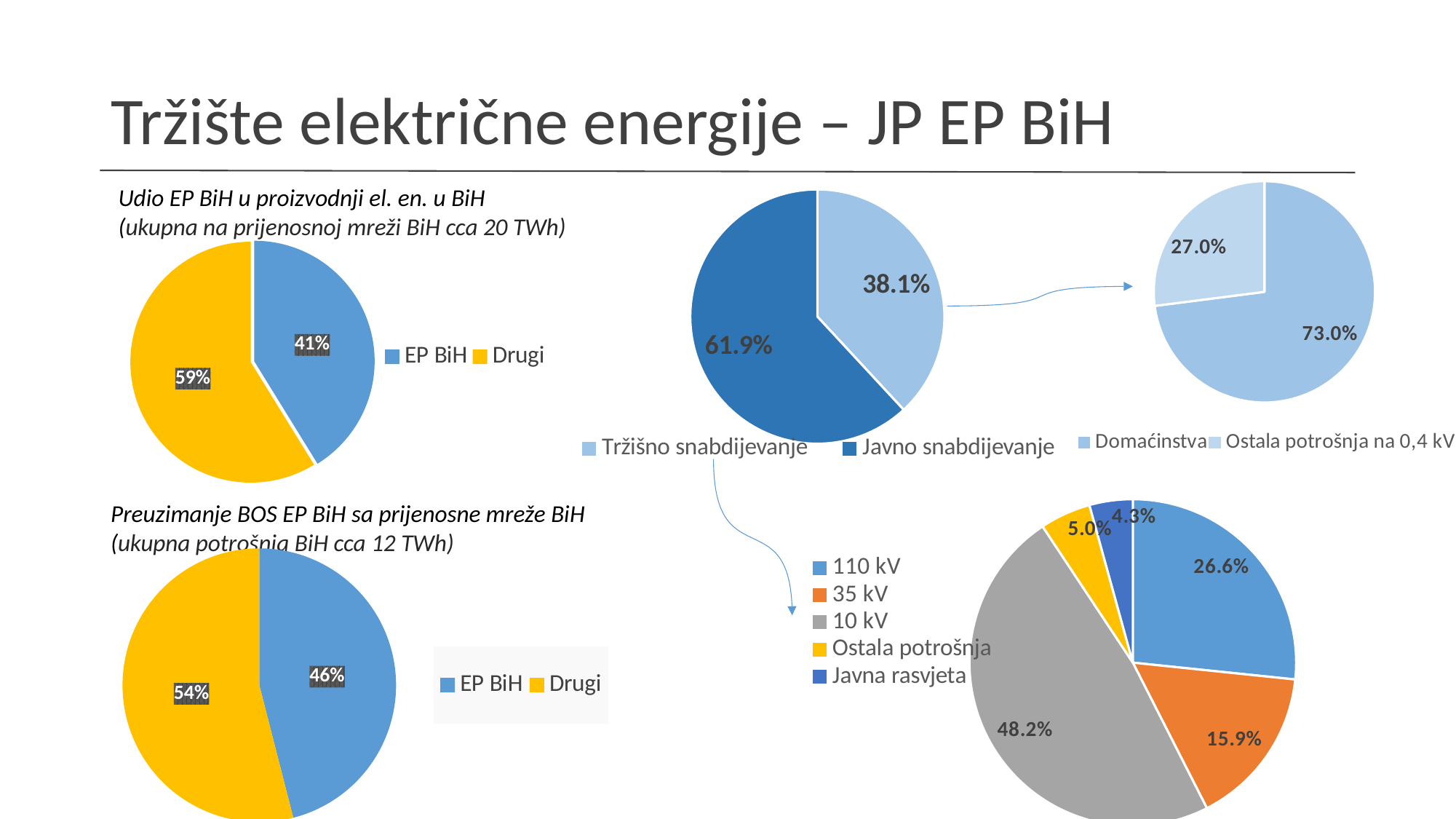
In the pie chart at the bottom right, what share does 35 kV have? 15.9% In the pie chart at the top centre, what is the difference between the Javno snabdijevanje and Tržišno snabdijevanje shares? 23.8% In the pie chart titled 'Preuzimanje BOS EP BiH sa prijenosne mreže BiH', what share does EP BiH have? 46% In the pie chart titled 'Udio EP BiH u proizvodnji el. en. u BiH', what share does Drugi have? 59% In the pie chart titled 'Preuzimanje BOS EP BiH sa prijenosne mreže BiH', which slice is larger, EP BiH or Drugi? Drugi In the pie chart at the top centre with the legend 'Tržišno snabdijevanje' and 'Javno snabdijevanje', what share does Javno snabdijevanje have? 61.9% In the pie chart at the top right with the legend 'Domaćinstva' and 'Ostala potrošnja na 0,4 kV', what share does Domaćinstva have? 73.0% In the pie chart at the bottom right, which category has the smallest share? Javna rasvjeta In the pie chart at the top right, what share does Ostala potrošnja na 0,4 kV have? 27.0% In the pie chart titled 'Udio EP BiH u proizvodnji el. en. u BiH', what share does EP BiH have? 41% In the pie chart at the bottom right, which category has the largest share? 10 kV How many categories does the legend of the pie chart at the bottom right list? 5